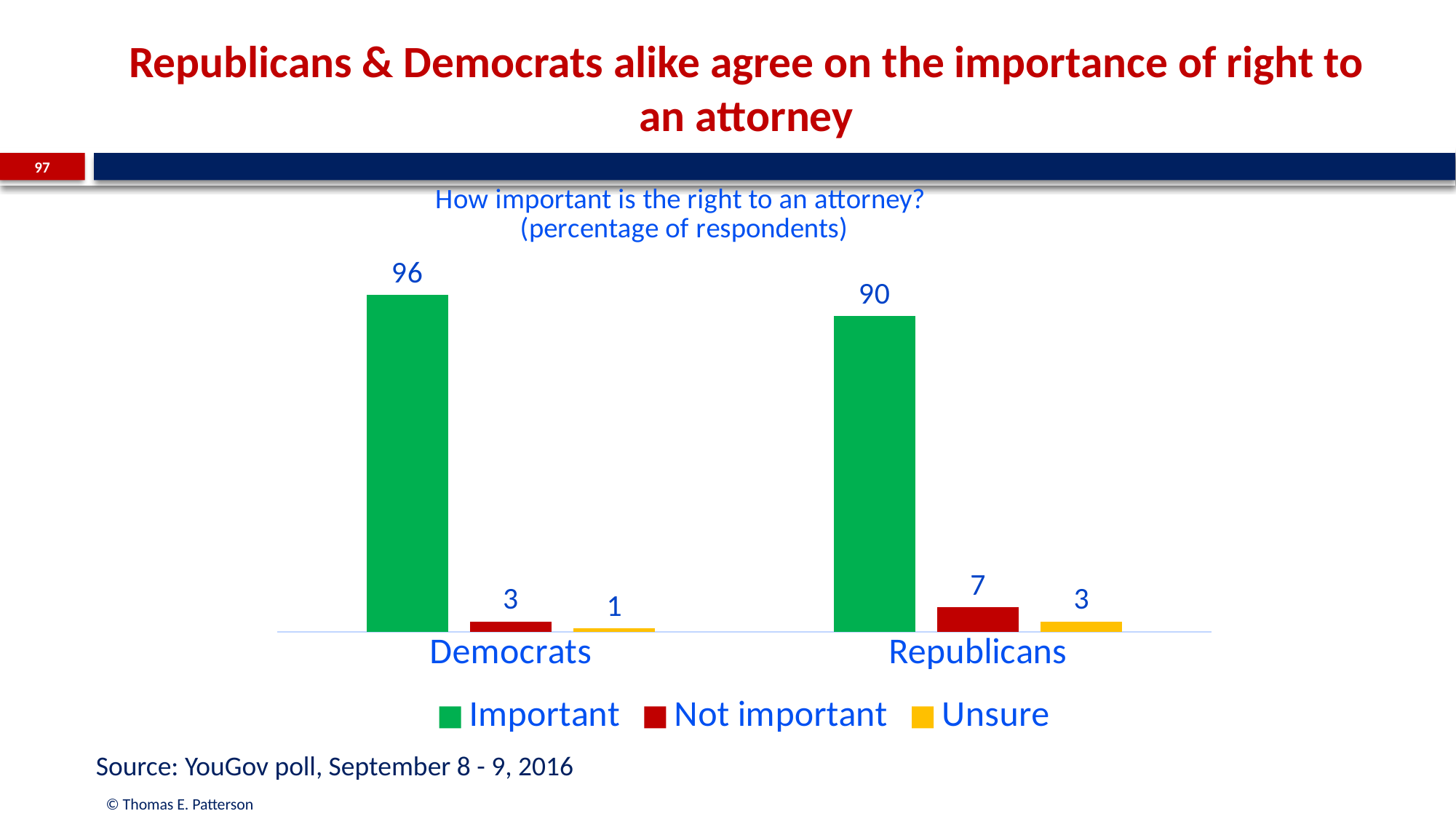
What is the value for Unsure among Democrats? 1 How many categories are shown on the x axis? 2 How many series does the legend list? 3 What percentage of Democrats say the right to an attorney is important? 96 What is the difference between the Not important values for Republicans and Democrats? 4 Which series has the highest value for Republicans? Important What is the difference between the Important values for Democrats and Republicans? 6 What is the value for Unsure among Republicans? 3 Which group has the higher value for Important, Democrats or Republicans? Democrats What percentage of Republicans say the right to an attorney is not important? 7 What kind of chart is shown on the slide? Bar chart Which series has the lowest value for Democrats? Unsure